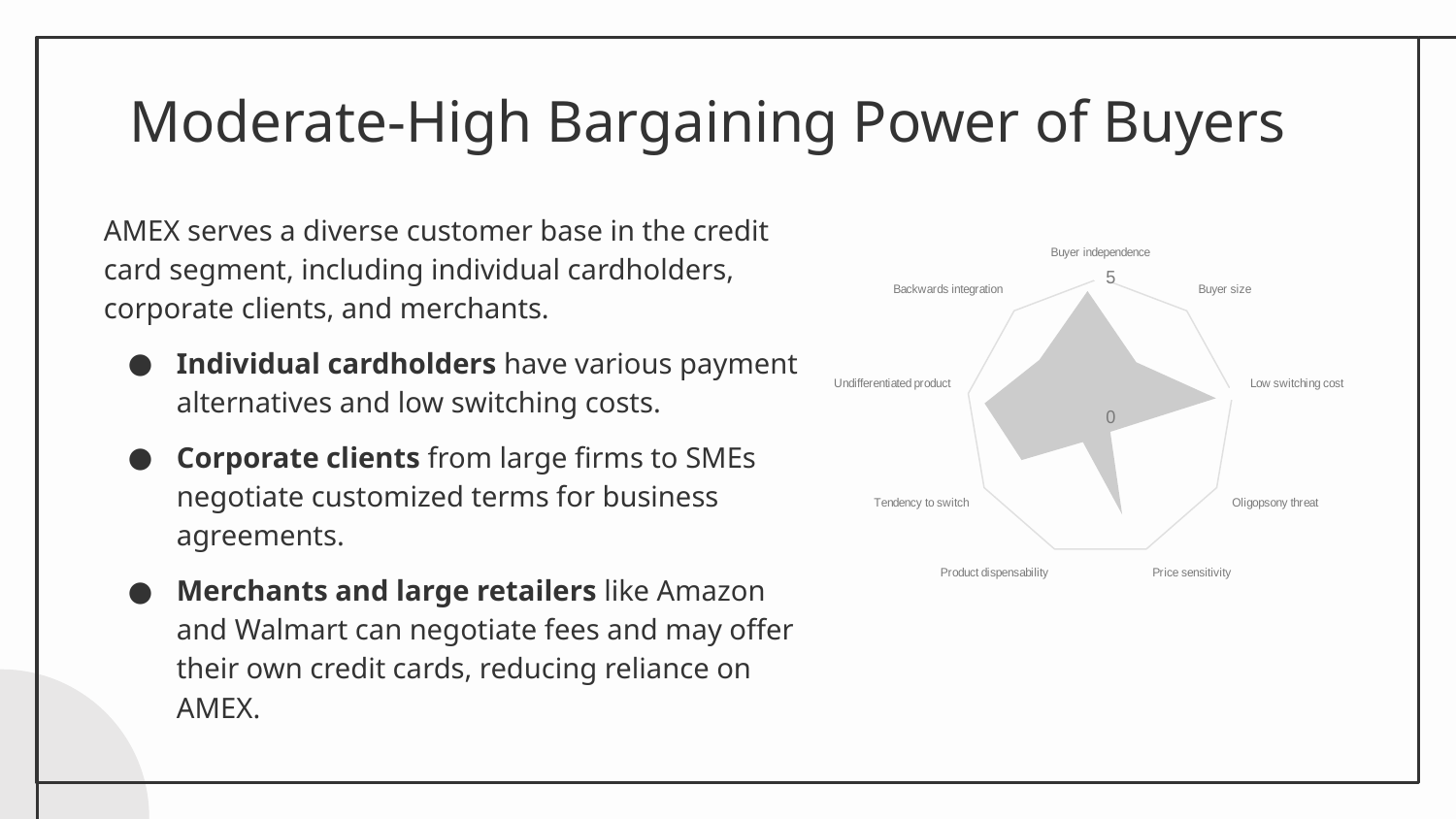
Is the value for Buyer size greater or less than 5? less How many categories (axes) does the radar chart have? 9 What kind of chart is shown on the slide? Radar chart Which is larger on the radar chart, the value for Undifferentiated product or the value for Backwards integration? Undifferentiated product Is the value for Tendency to switch greater or less than 5? less Which is larger on the radar chart, the value for Buyer independence or the value for Buyer size? Buyer independence Which is larger on the radar chart, the value for Low switching cost or the value for Tendency to switch? Low switching cost What is the maximum value shown on the radar chart's scale? 5 What is the minimum value shown on the radar chart's scale? 0